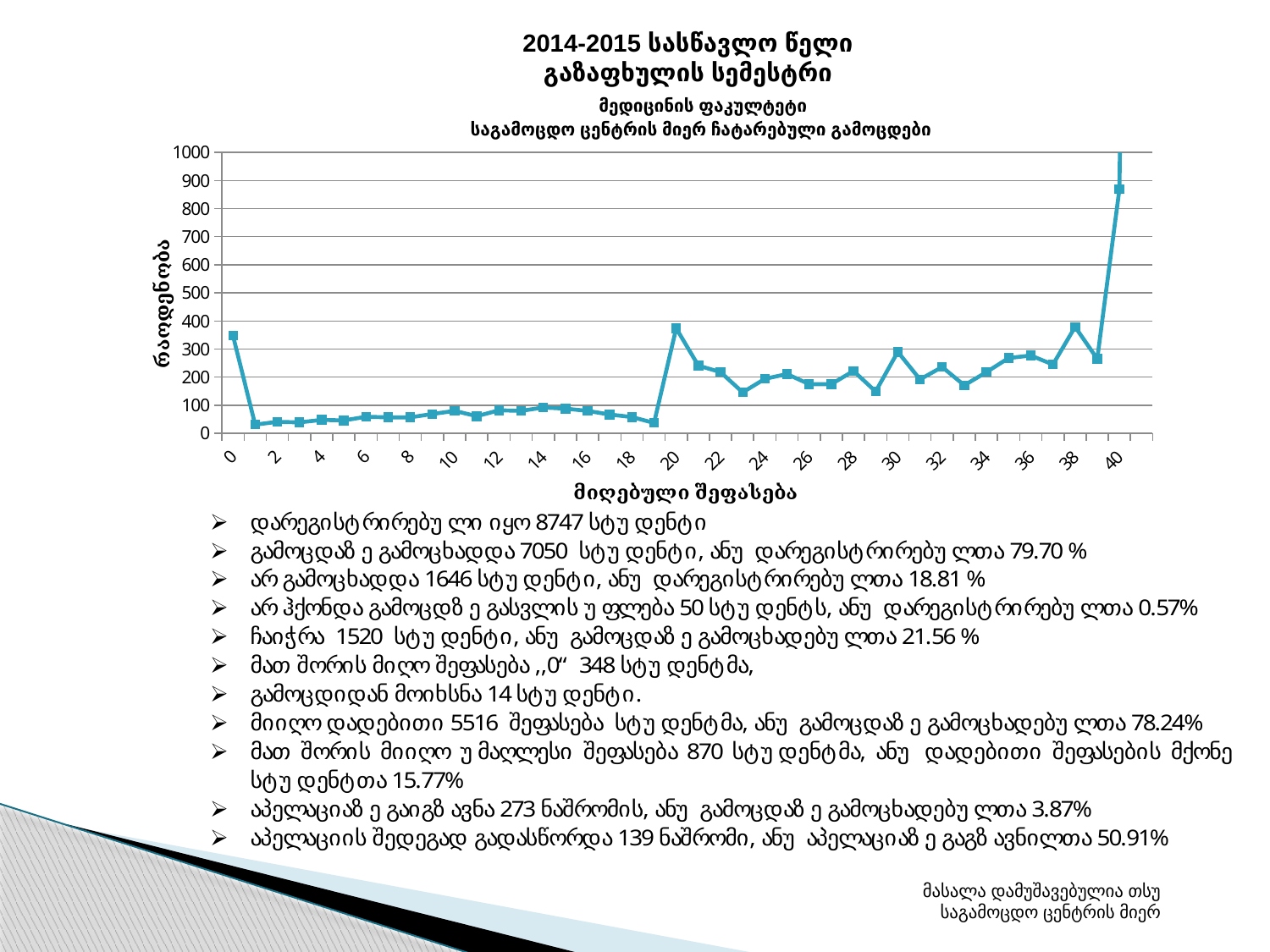
Which has the larger value, score 38 or score 30? score 38 What kind of chart is shown on the slide? line chart Is the value for score 10 greater or less than 100? less Is the value for score 23 greater or less than 200? less At which score on the x axis does the line reach its highest plotted point? 40 Is the value for score 30 greater or less than 200? greater Does the line rise or fall between score 0 and score 1? fall What is the label on the y axis of the chart? რაოდენობა Which has the larger value, score 20 or score 10? score 20